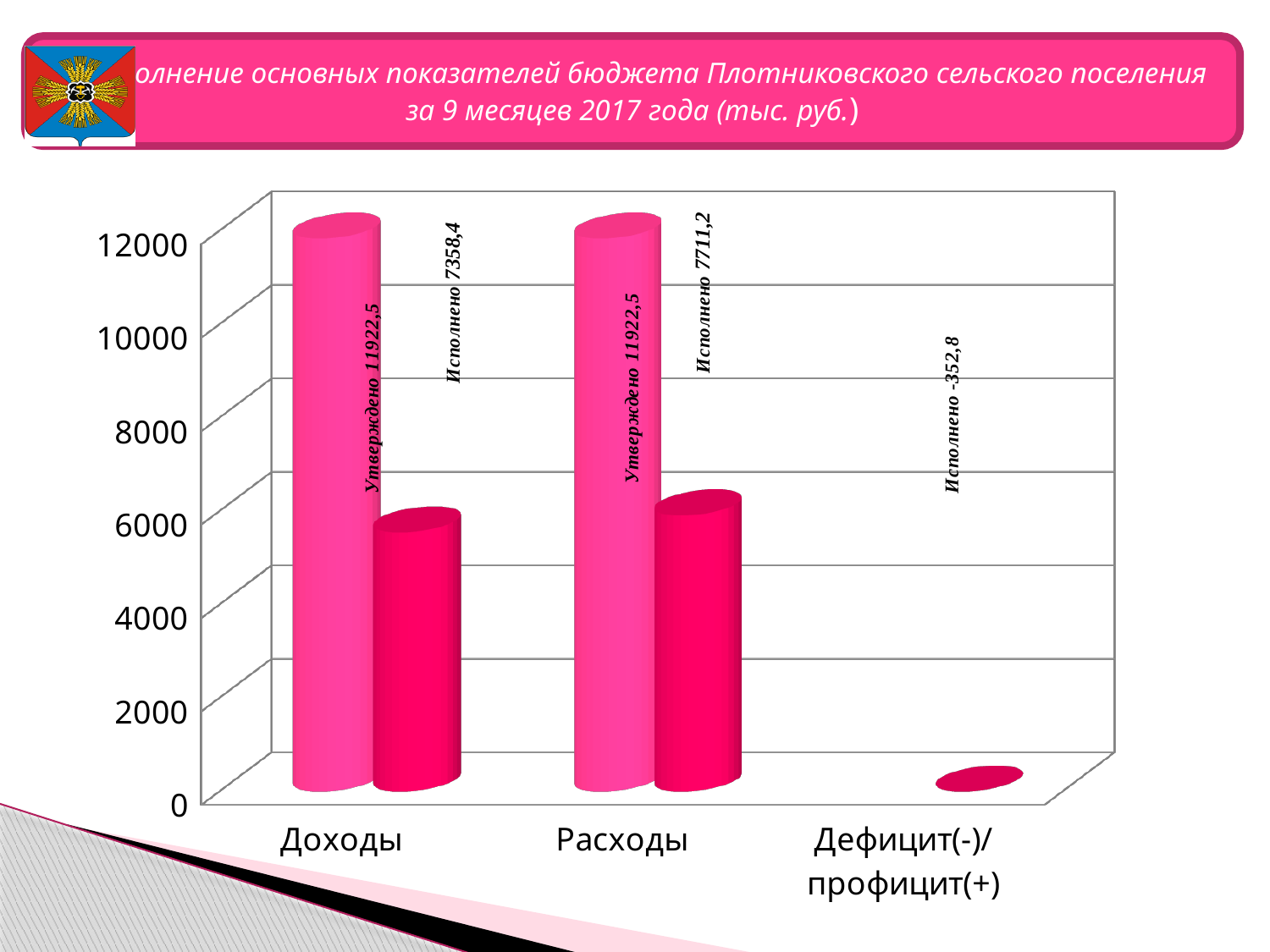
What is the difference between the approved and executed values for Расходы? 4211,3 What is the difference between the approved and executed values for Доходы? 4564,1 Which is larger, the executed value for Доходы or the executed value for Расходы? Расходы How many categories are shown on the x axis? 3 What is the executed (Исполнено) value for Доходы? 7358,4 What is the approved (Утверждено) value for Расходы? 11922,5 Is the executed (Исполнено) value for Доходы greater or less than 8000? less What is the approved (Утверждено) value for Доходы? 11922,5 In what units are the values given, according to the slide title? тыс. руб. What is the executed (Исполнено) value for Расходы? 7711,2 What is the executed (Исполнено) value for Дефицит(-)/профицит(+)? -352,8 What kind of chart is shown on the slide? Bar chart